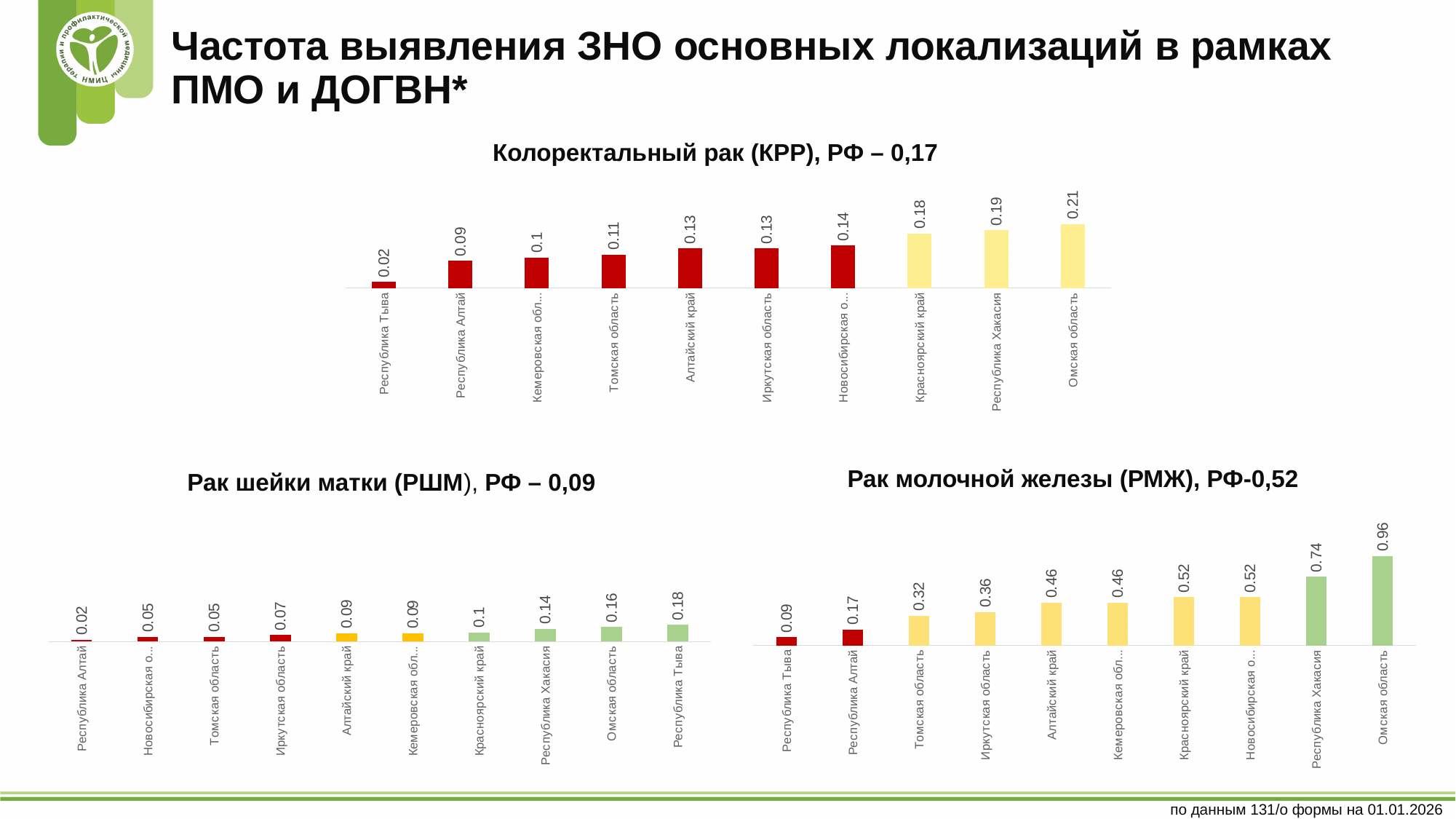
In the chart 'Рак шейки матки (РШМ), РФ – 0,09', how many regions are shown? 10 In the chart 'Рак молочной железы (РМЖ), РФ-0,52', do the values rise or fall from left to right? rise In the chart 'Рак молочной железы (РМЖ), РФ-0,52', what is the difference between Омская область and Республика Тыва? 0.87 In the chart 'Колоректальный рак (КРР), РФ – 0,17', what is the difference between Омская область and Республика Хакасия? 0.02 In the chart 'Рак шейки матки (РШМ), РФ – 0,09', which region has the highest value? Республика Тыва What type of chart is used for 'Колоректальный рак (КРР), РФ – 0,17'? bar chart In the chart 'Колоректальный рак (КРР), РФ – 0,17', which region has the highest value? Омская область In the chart 'Рак молочной железы (РМЖ), РФ-0,52', what is the value for Республика Хакасия? 0.74 In the chart 'Рак шейки матки (РШМ), РФ – 0,09', what is the value for Республика Хакасия? 0.14 In the chart 'Рак молочной железы (РМЖ), РФ-0,52', which is larger: Томская область or Иркутская область? Иркутская область In the chart 'Колоректальный рак (КРР), РФ – 0,17', which region has the lowest value? Республика Тыва In the chart 'Колоректальный рак (КРР), РФ – 0,17', what is the value for Томская область? 0.11